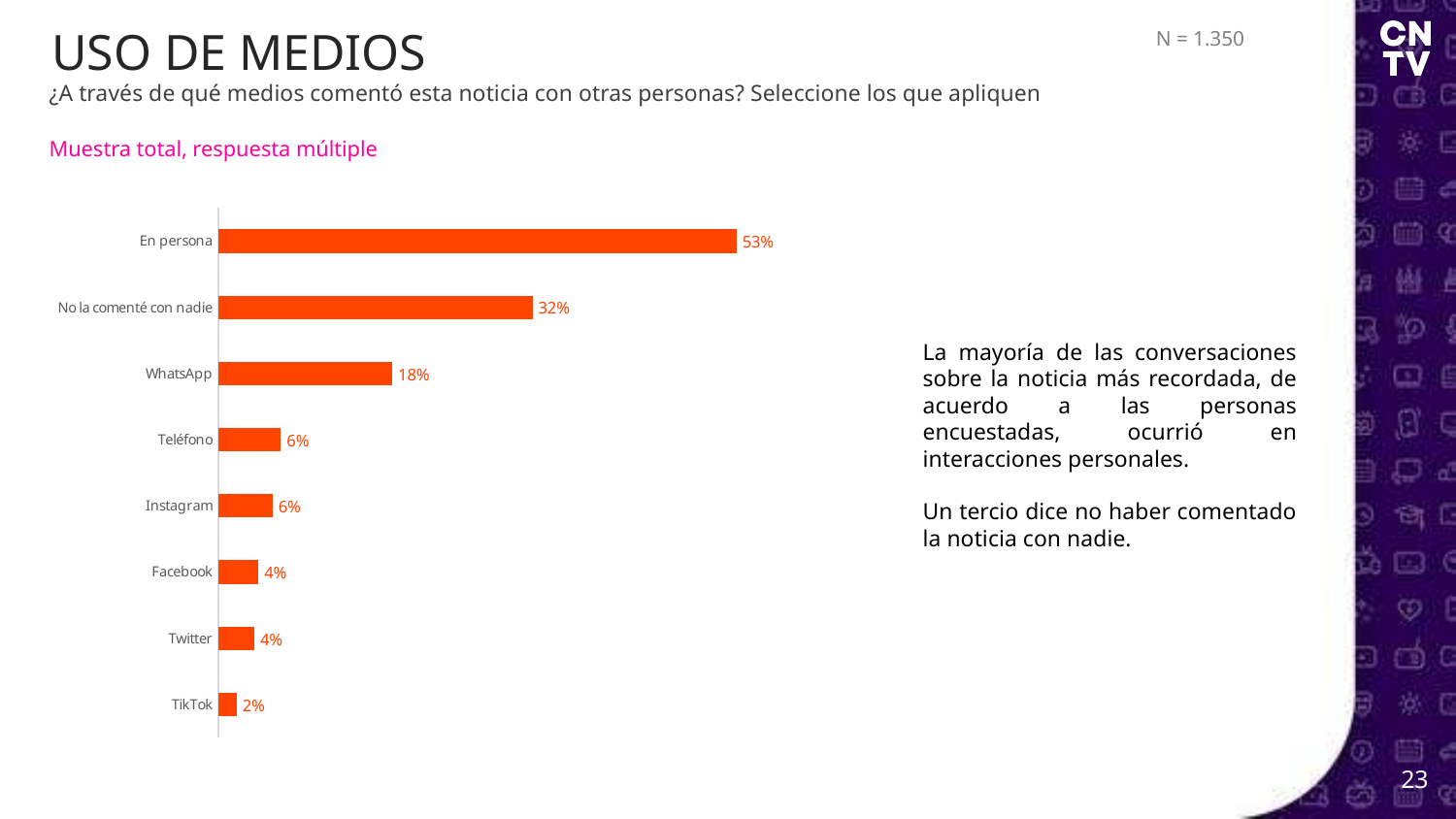
How many categories are shown in the chart? 8 What is the value for TikTok? 2% Which category has the highest value? En persona What is the value for No la comenté con nadie? 32% What is the difference between the values for WhatsApp and Facebook? 14% What is the difference between the values for En persona and No la comenté con nadie? 21% What is the sample size (N) shown on the slide? N = 1.350 What kind of chart is shown on the slide? Bar chart Which category has the lowest value? TikTok Which is larger, the value for WhatsApp or the value for Teléfono? WhatsApp What is the value for WhatsApp? 18% What is the value for En persona? 53%